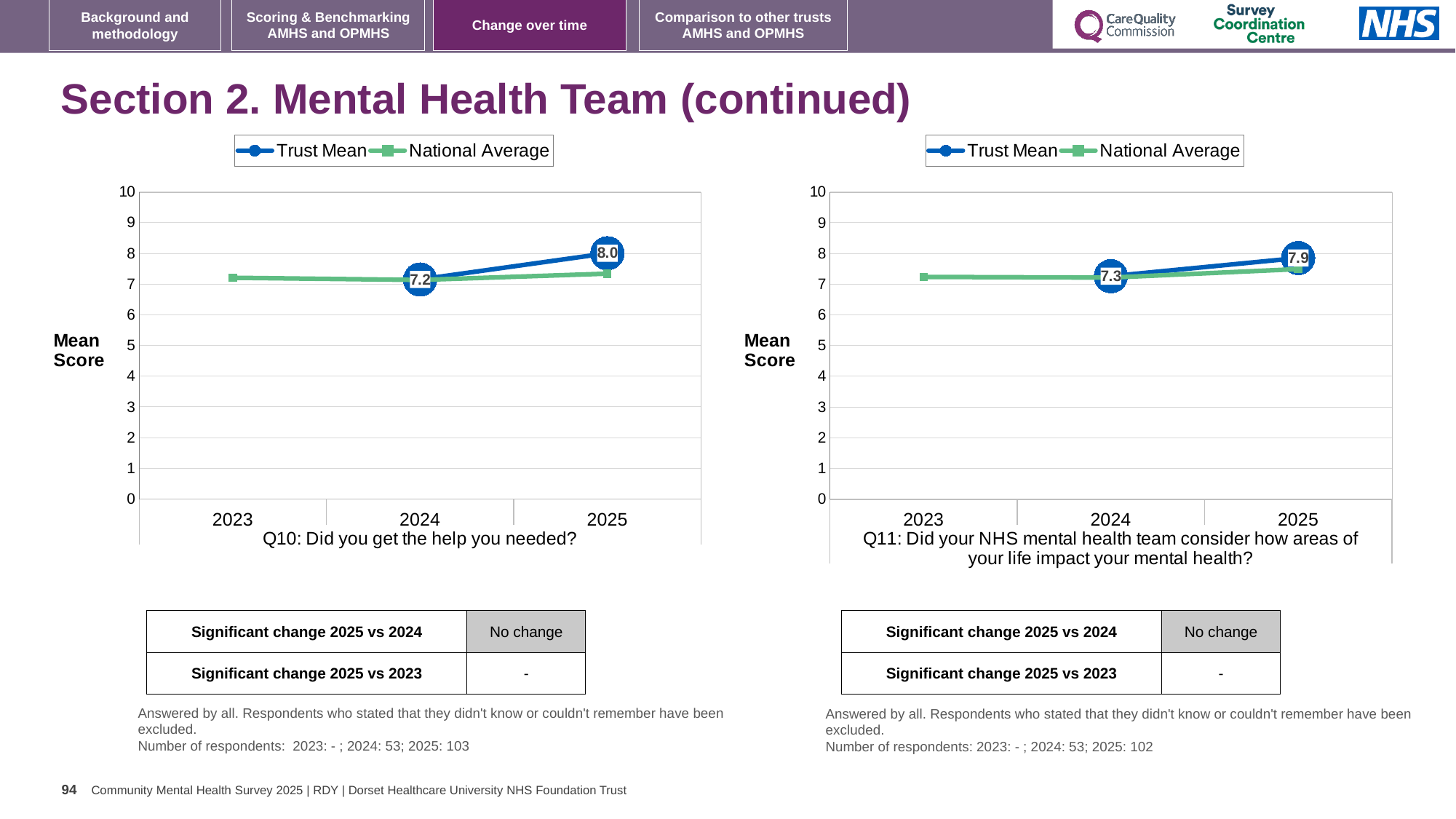
In the Q10 chart (left), what is the Trust Mean score for 2025? 8.0 In the Q11 chart (right), what is the Trust Mean score for 2024? 7.3 In the Q11 chart (right), what is the difference between the Trust Mean for 2025 and 2024? 0.6 What kind of chart is the Q11 chart (right)? line chart In the Q10 chart (left), what is the Trust Mean score for 2024? 7.2 How many series does the legend of the Q10 chart (left) list? 2 In the Q10 chart (left), by how much did the Trust Mean increase from 2024 to 2025? 0.8 In the Q11 chart (right), what is the Trust Mean score for 2025? 7.9 In the Q11 chart (right), is the National Average value for 2023 greater or less than 8? less In the Q11 chart (right), which year has the higher Trust Mean, 2024 or 2025? 2025 How many years are shown on the x axis of the Q10 chart (left)? 3 In the Q10 chart (left), does the Trust Mean rise or fall from 2024 to 2025? rise